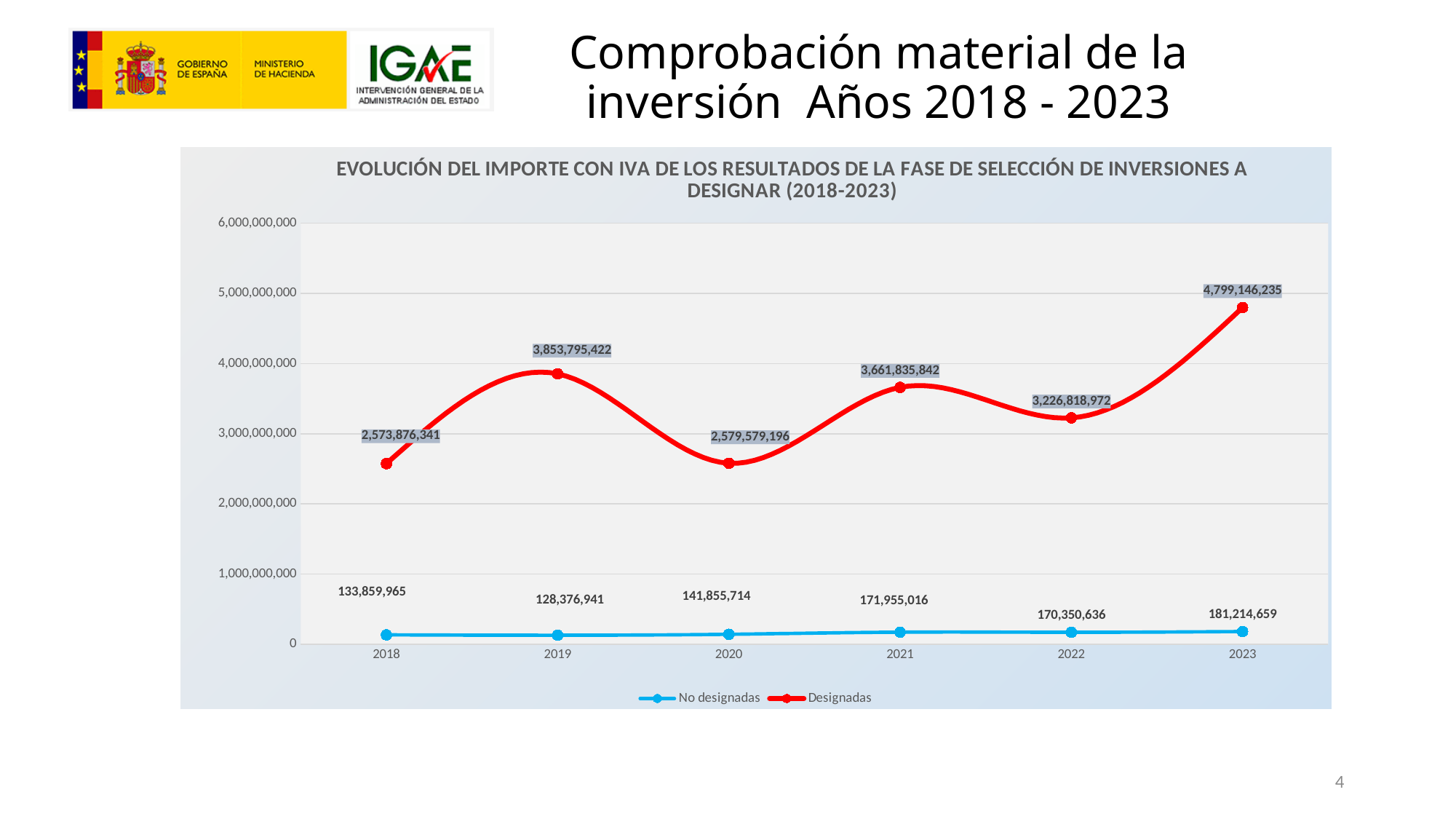
What is the value for Designadas in 2020? 2,579,579,196 Which is larger, the Designadas value for 2019 or for 2021? 2019 By how much did the No designadas value increase from 2018 to 2023? 47,354,694 In which year is the Designadas series highest? 2023 In which year is the No designadas series lowest? 2019 What is the difference between the Designadas values for 2023 and 2022? 1,572,327,263 What kind of chart is shown on the slide? Line chart What is the value for No designadas in 2021? 171,955,016 What is the value for Designadas in 2023? 4,799,146,235 How many years are plotted on the x axis? 6 How many series does the legend list? 2 Is the Designadas value for 2022 greater or less than 3,000,000,000? greater